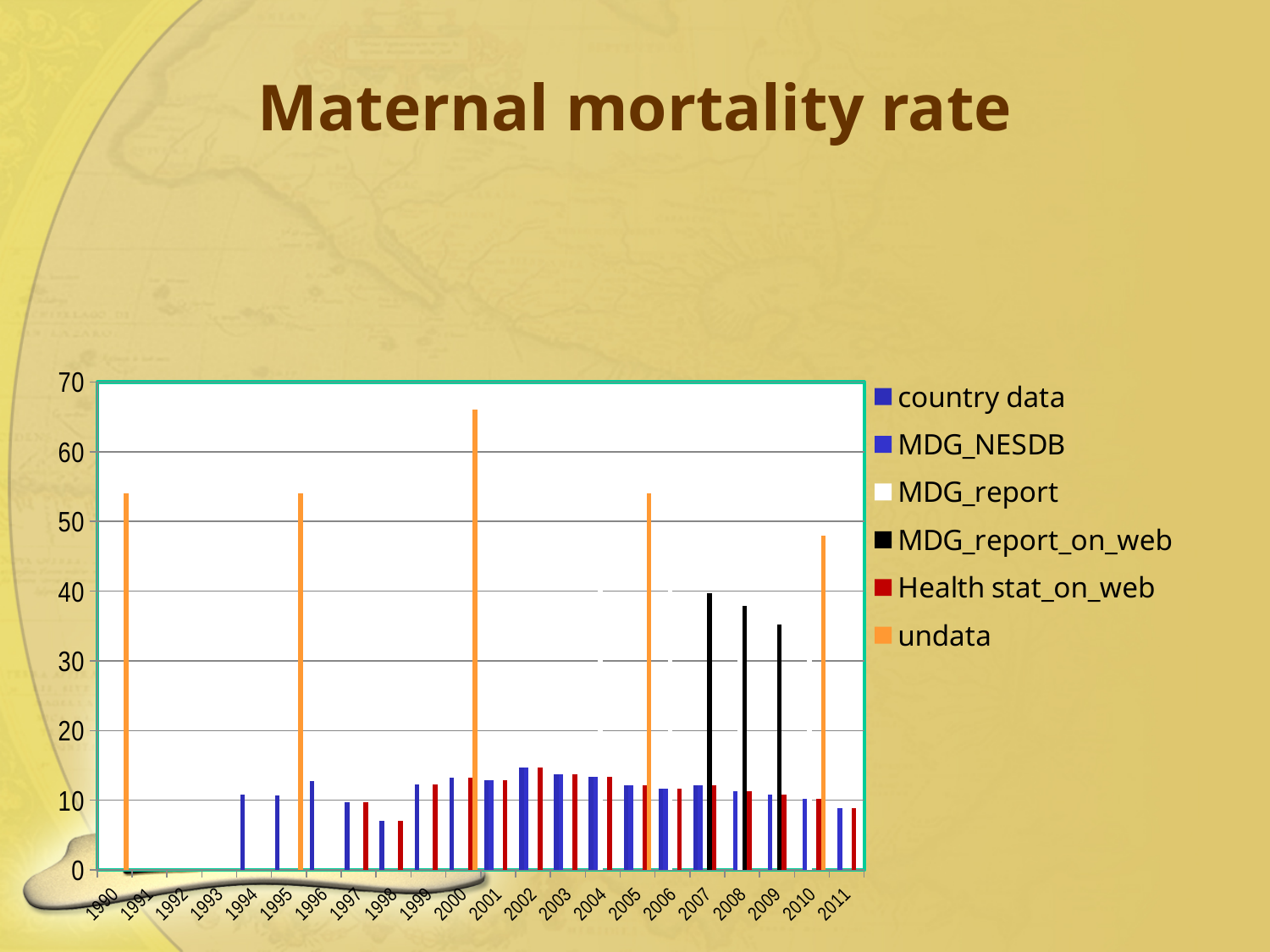
Is the undata value for 2010 greater or less than 60? less How many years are shown on the x axis? 22 Is the MDG_report_on_web value for 2009 greater or less than 40? less Is the undata value for 2000 greater or less than 60? greater In which year is the undata series highest? 2000 Which colour represents the undata series in the legend? orange Which is larger, the undata value for 2000 or the undata value for 1990? 2000 What kind of chart is shown on the slide? bar chart In which year is the undata series lowest? 2010 What is the title of the chart? Maternal mortality rate How many series does the legend list? 6